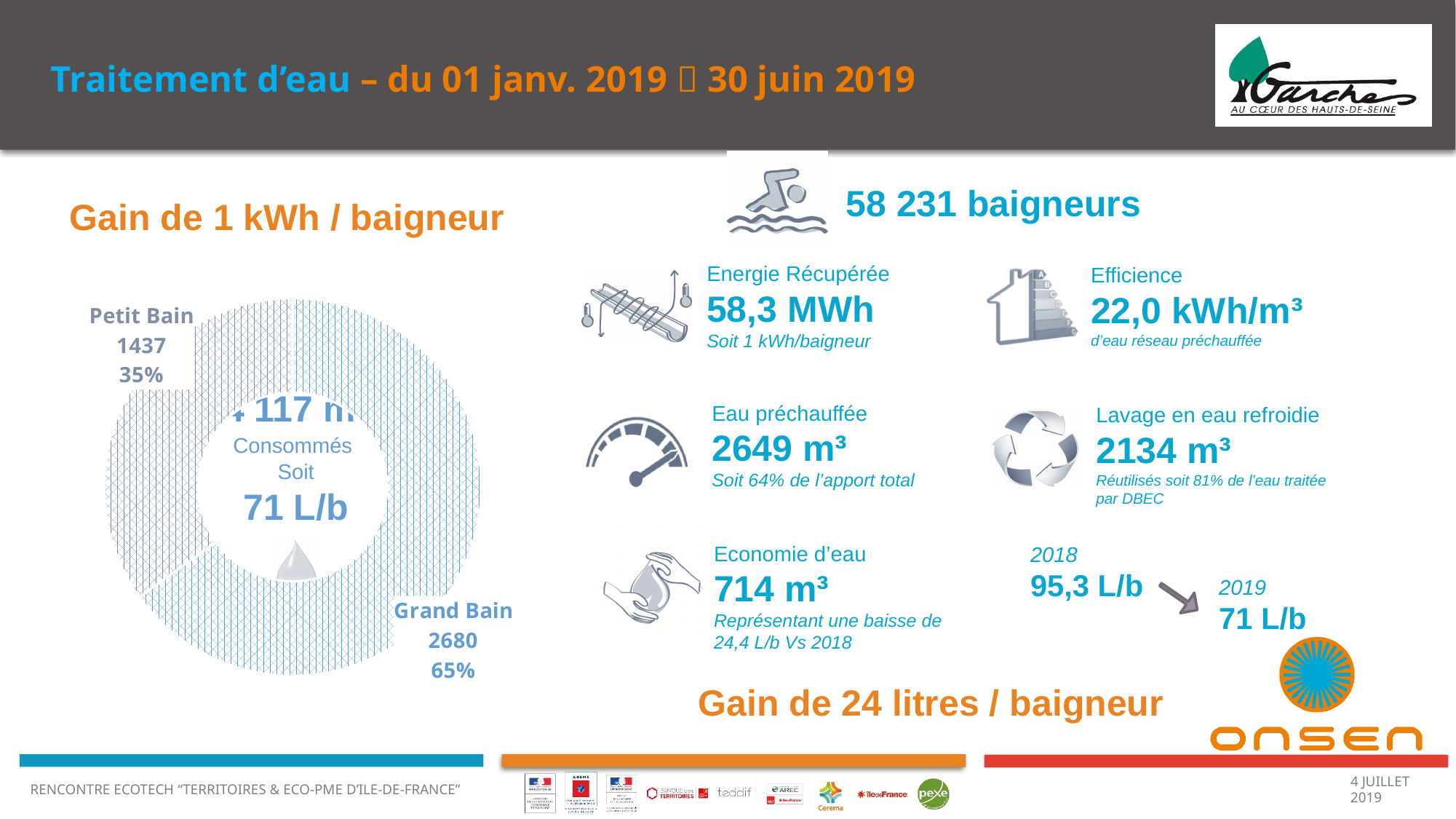
What is the value for Petit Bain in the doughnut chart? 1437 Which is larger in the doughnut chart, Petit Bain or Grand Bain? Grand Bain How many categories does the doughnut chart show? 2 What is the total of the two values shown in the doughnut chart? 4117 What kind of chart is shown on the left of the slide? doughnut chart What value in L/b is printed in the centre of the doughnut chart? 71 L/b What is the value for Grand Bain in the doughnut chart? 2680 What share of the doughnut chart does Grand Bain represent? 65% What is the difference between the Grand Bain and Petit Bain values in the doughnut chart? 1243 Which category has the largest slice in the doughnut chart? Grand Bain What share of the doughnut chart does Petit Bain represent? 35% Which category has the smallest slice in the doughnut chart? Petit Bain